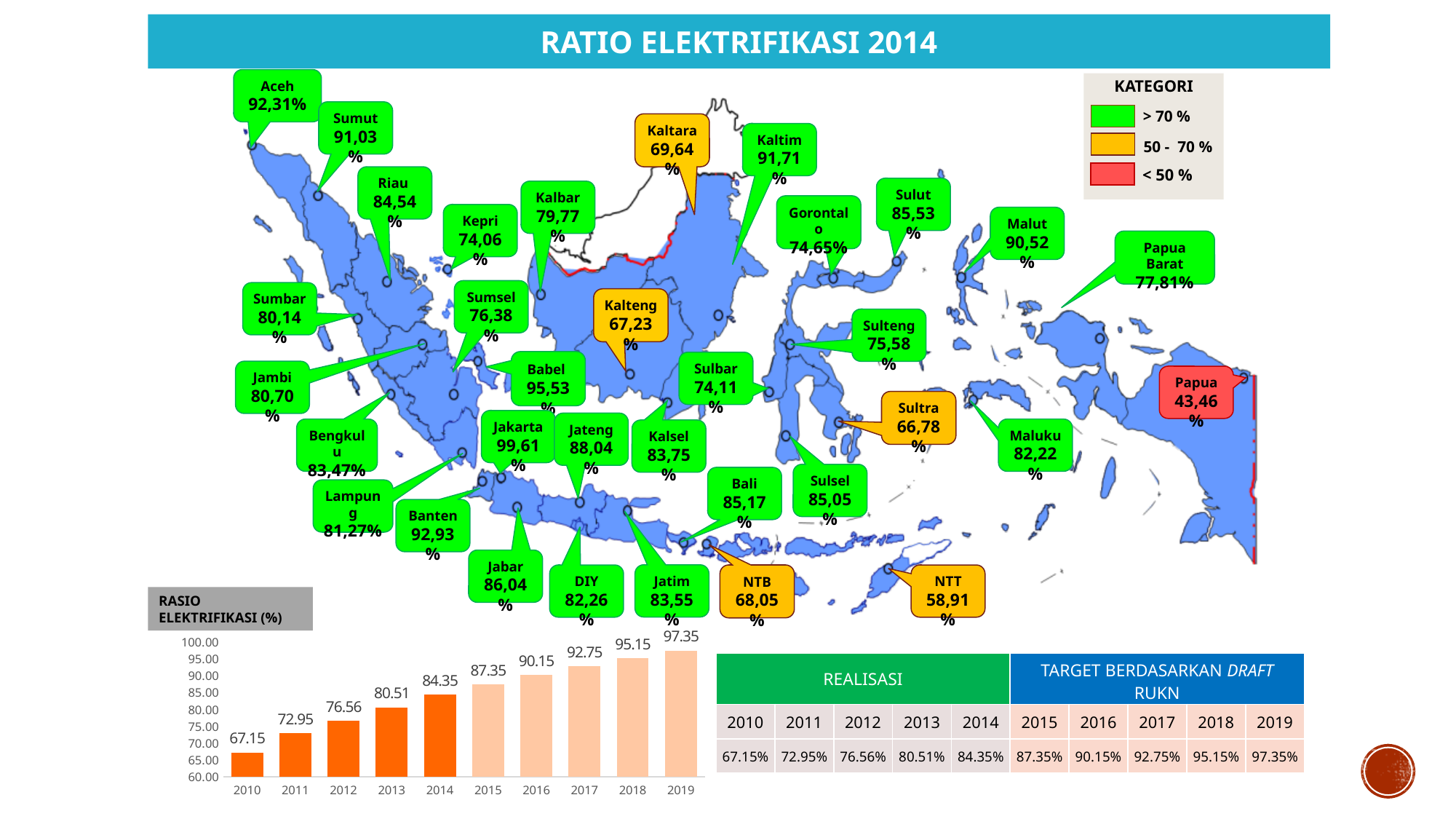
In the bar chart at the bottom left, what is the difference between the values for 2014 and 2010? 17.20 How many years are shown on the x axis of the bar chart at the bottom left? 10 In the bar chart at the bottom left, what is the value for 2019? 97.35 In the bar chart at the bottom left, what is the value for 2014? 84.35 What kind of chart is shown at the bottom left of the slide? bar chart What is the title of the bar chart at the bottom left of the slide? RASIO ELEKTRIFIKASI (%) In the bar chart at the bottom left, which year has the highest value? 2019 In the bar chart at the bottom left, what is the value for 2010? 67.15 In the bar chart at the bottom left, which is larger, the value for 2012 or the value for 2013? 2013 In the bar chart at the bottom left, do the values rise or fall from 2010 to 2019? rise In the bar chart at the bottom left, is the value for 2016 greater or less than 85.00? greater In the bar chart at the bottom left, which year has the lowest value? 2010